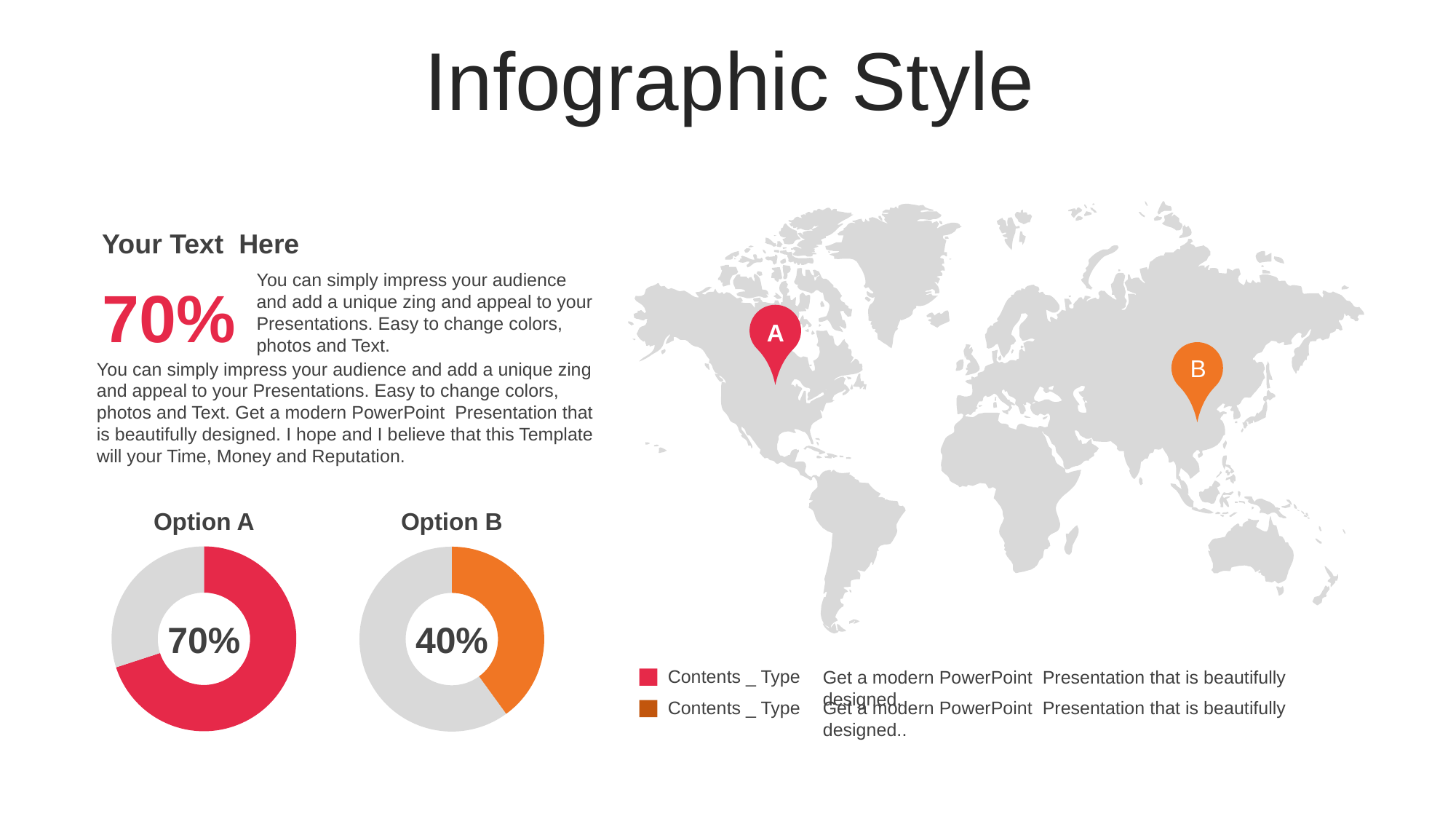
Is the value for Option B greater or less than 50%? less What colour is the filled segment of the Option A donut chart? Red What value is shown in the centre of the Option A donut chart? 70% What kind of chart is used for Option A and Option B? Donut chart Which of the two donut charts shows the lowest percentage? Option B How many donut charts are shown on the slide? 2 Which option has the higher percentage, Option A or Option B? Option A What is the difference between the Option A percentage and the Option B percentage? 30% What value is shown in the centre of the Option B donut chart? 40% Is the value for Option A greater or less than 50%? greater What colour is the filled segment of the Option B donut chart? Orange